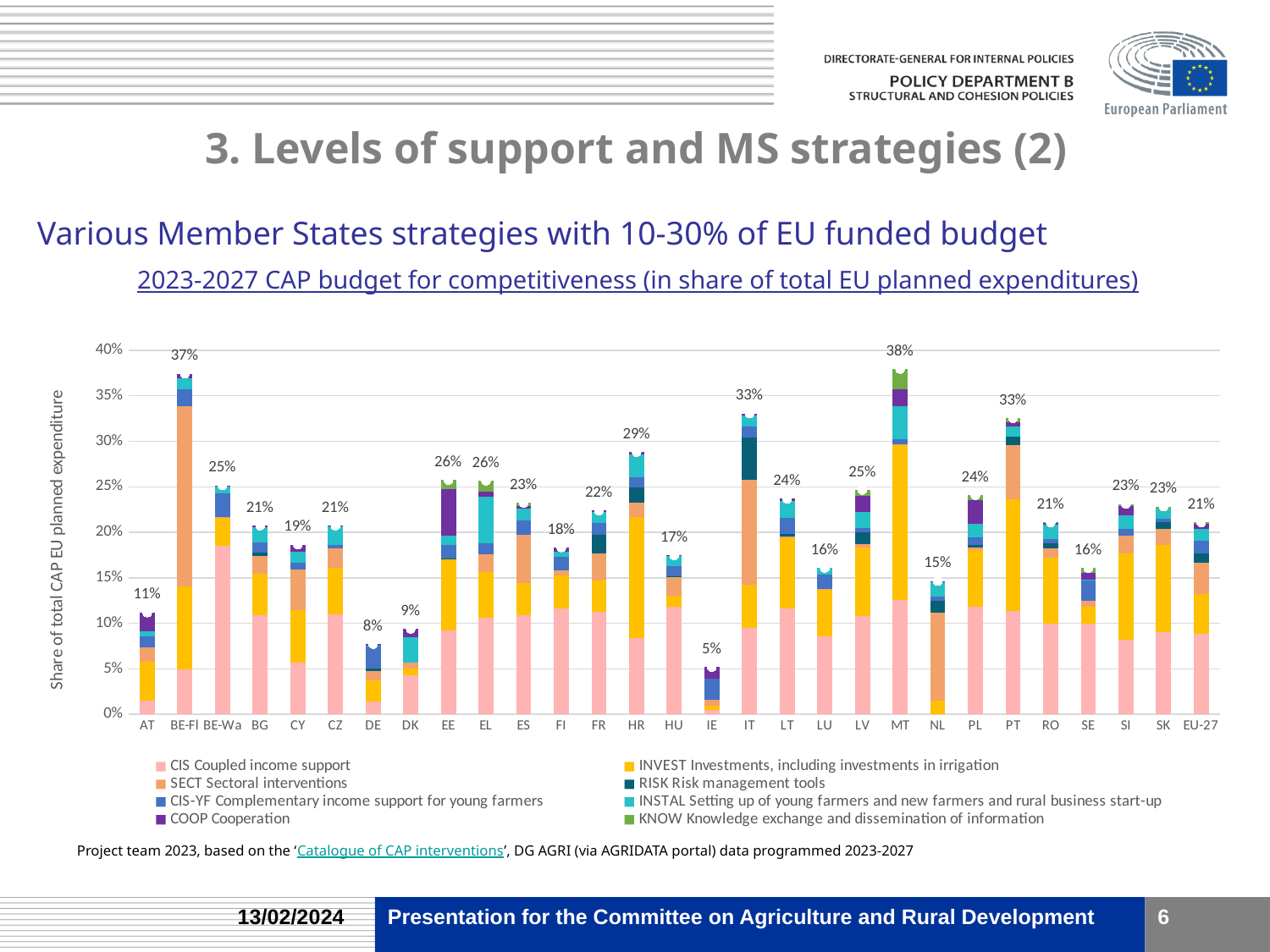
What is the total labelled value for HR? 29% Which Member State has the highest total share of CAP EU planned expenditure for competitiveness? MT What kind of chart is shown on the slide? Stacked bar chart Which has a larger total share, BE-Fl or BE-Wa? BE-Fl How many series does the legend list? 8 Which Member State has the lowest total share of CAP EU planned expenditure for competitiveness? IE What is the difference in percentage points between the total for MT and the total for IE? 33 percentage points Is the total value for IT greater or less than 30%? greater Which legend entry is shown in pink at the bottom of each bar? CIS Coupled income support What is the total labelled value for MT? 38% What is the total labelled value for EU-27? 21% How many Member State/aggregate categories are shown on the x axis? 29